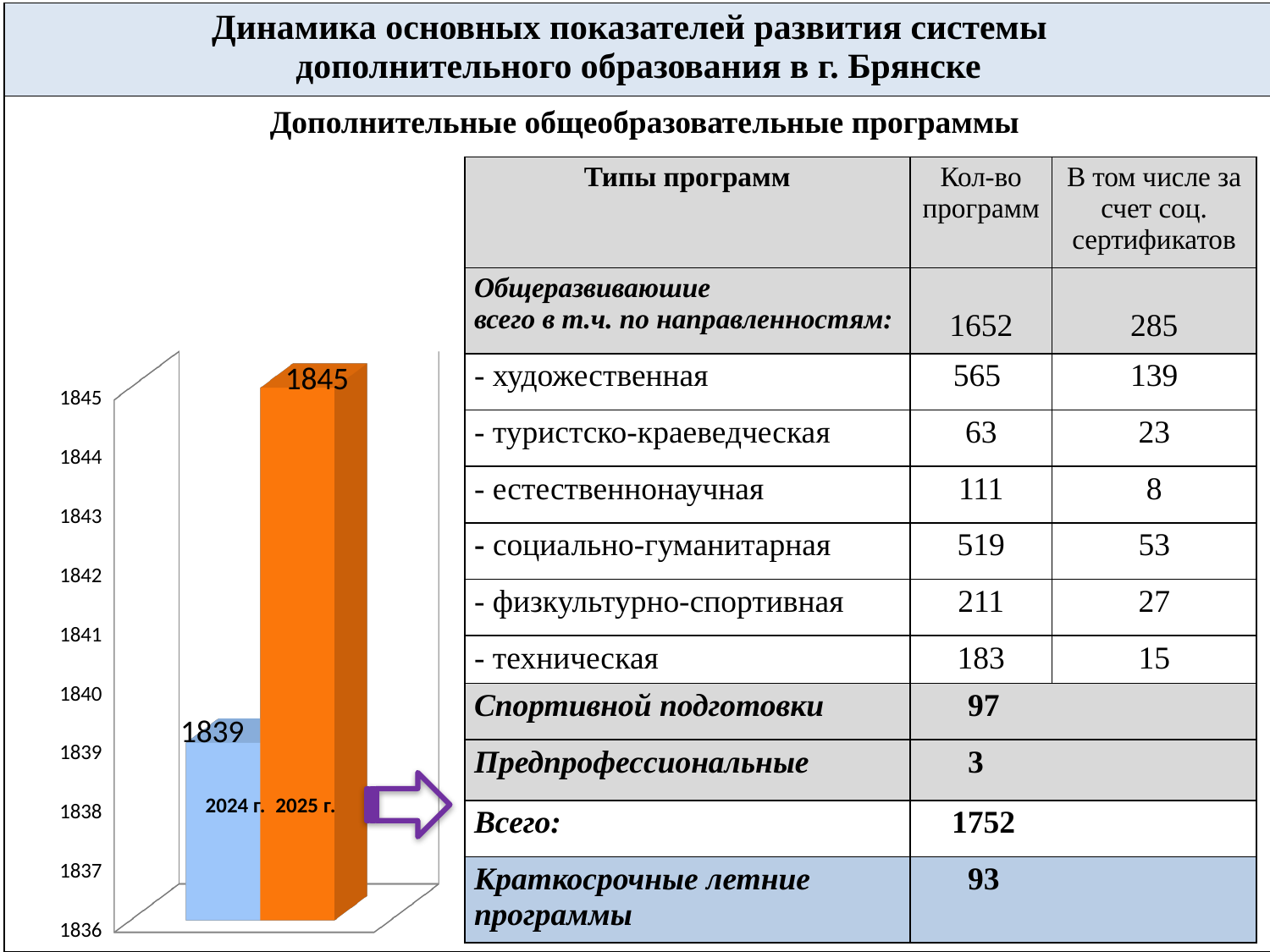
Do the values in the chart rise or fall from 2024 г. to 2025 г.? rise What is the lowest value shown on the chart's vertical axis? 1836 What kind of chart is shown on the left of the slide? bar chart What colour is the bar for 2025 г.? orange Is the value for 2024 г. greater or less than 1840? less Which year has the lower value in the chart? 2024 г. By how much does the value for 2025 г. exceed the value for 2024 г. in the chart? 6 What value does the chart show for 2025 г.? 1845 What value does the chart show for 2024 г.? 1839 How many bars are plotted in the chart? 2 Is the value for 2025 г. larger or smaller than the value for 2024 г.? larger Which year has the higher value in the chart? 2025 г.